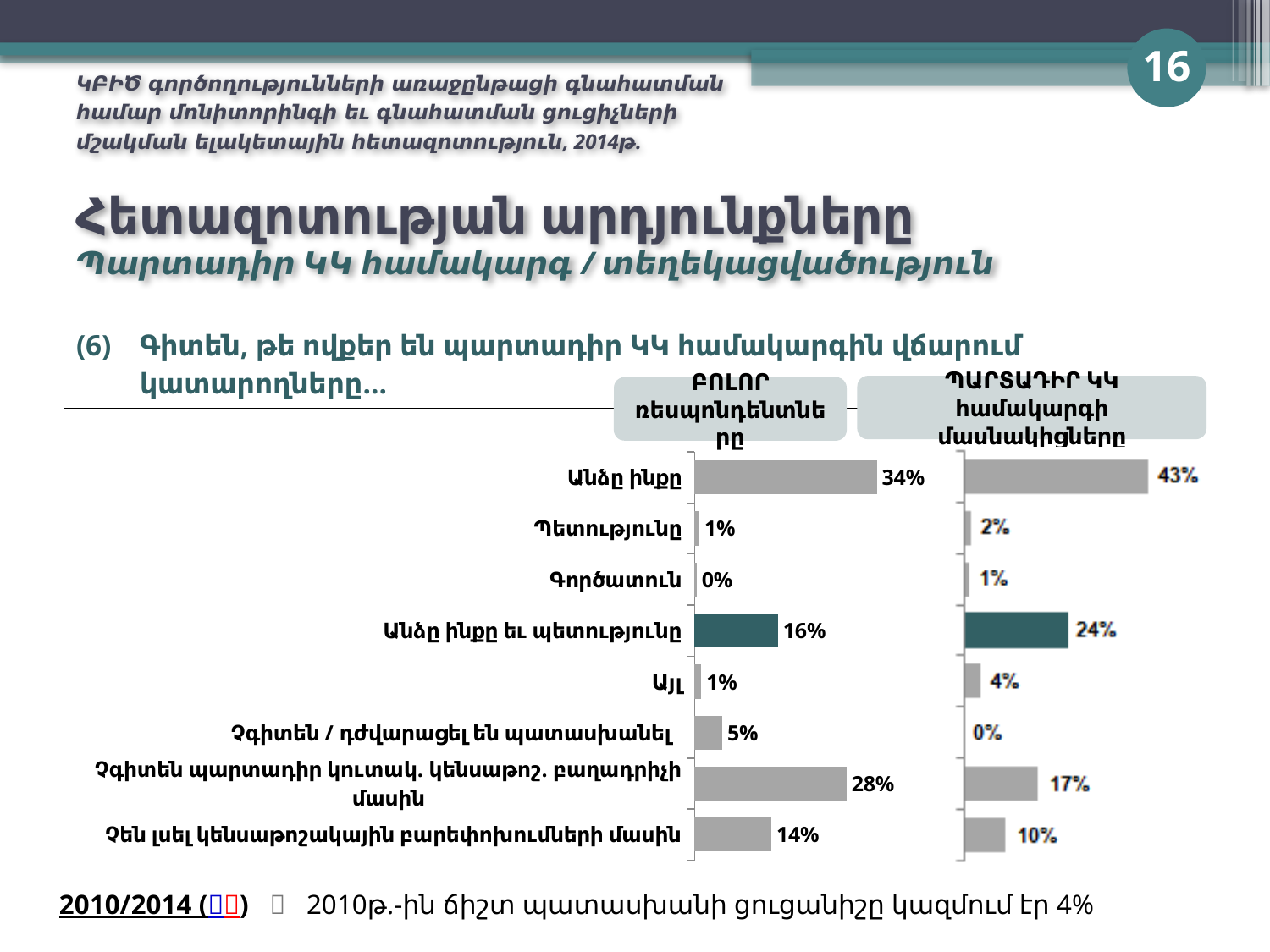
In the left chart (ԲՈԼՈՐ ռեսպոնդենտները), which category has the lowest value? Գործատուն What is the difference between the value for Անձը ինքը in the right chart (ՊԱՐՏԱԴԻՐ ԿԿ համակարգի մասնակիցները) and in the left chart (ԲՈԼՈՐ ռեսպոնդենտները)? 9% In the right chart (ՊԱՐՏԱԴԻՐ ԿԿ համակարգի մասնակիցները), what is the value for Այլ? 4% How many categories are shown in the left chart (ԲՈԼՈՐ ռեսպոնդենտները)? 8 In the right chart (ՊԱՐՏԱԴԻՐ ԿԿ համակարգի մասնակիցները), which category has the lowest value? Չգիտեն / դժվարացել են պատասխանել In the left chart (ԲՈԼՈՐ ռեսպոնդենտները), what is the value for Անձը ինքը? 34% In the right chart (ՊԱՐՏԱԴԻՐ ԿԿ համակարգի մասնակիցները), which category has the highest value? Անձը ինքը In the right chart (ՊԱՐՏԱԴԻՐ ԿԿ համակարգի մասնակիցները), what is the value for Անձը ինքը և պետությունը? 24% What type of chart is used on this slide? Bar chart In the left chart (ԲՈԼՈՐ ռեսպոնդենտները), what is the difference between Անձը ինքը and Չգիտեն պարտադիր կուտակ. կենսաթոշ. բաղադրիչի մասին? 6% Which is larger: the value for Չեն լսել կենսաթոշակային բարեփոխումների մասին in the left chart (ԲՈԼՈՐ ռեսպոնդենտները) or in the right chart (ՊԱՐՏԱԴԻՐ ԿԿ համակարգի մասնակիցները)? Left chart (ԲՈԼՈՐ ռեսպոնդենտները) In the left chart (ԲՈԼՈՐ ռեսպոնդենտները), what is the value for Չգիտեն պարտադիր կուտակ. կենսաթոշ. բաղադրիչի մասին? 28%